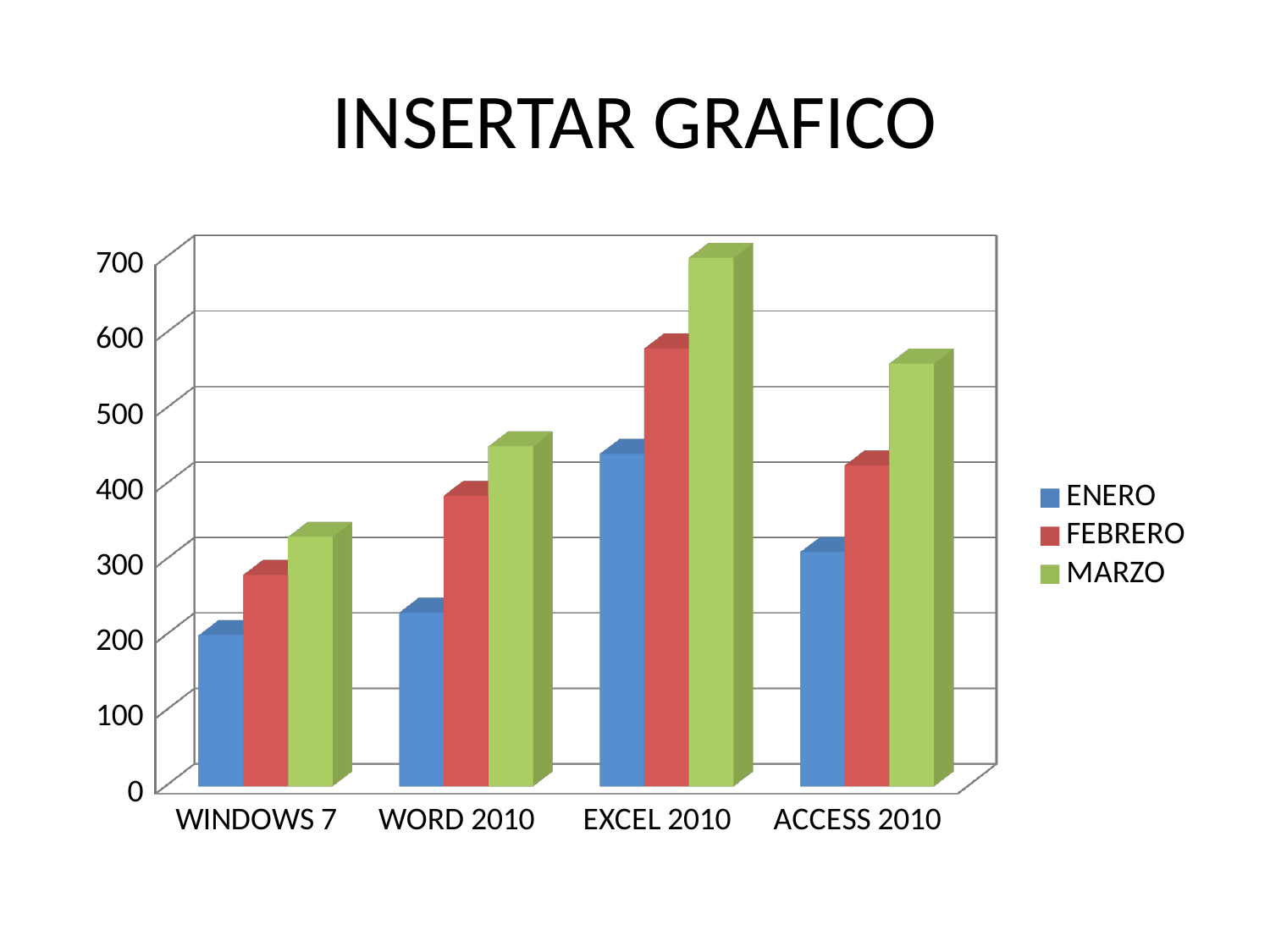
Which category has the highest MARZO value? EXCEL 2010 Which is larger, the MARZO value for EXCEL 2010 or the MARZO value for ACCESS 2010? EXCEL 2010 Which category has the lowest ENERO value? WINDOWS 7 Is the MARZO value for EXCEL 2010 greater or less than 600? greater Is the ENERO value for WINDOWS 7 greater or less than 300? less Which category has the lowest FEBRERO value? WINDOWS 7 Is the FEBRERO value for EXCEL 2010 greater or less than 500? greater How many categories are shown on the x axis? 4 What kind of chart is shown on the slide? bar chart Which series is shown in green in the legend? MARZO How many series does the legend list? 3